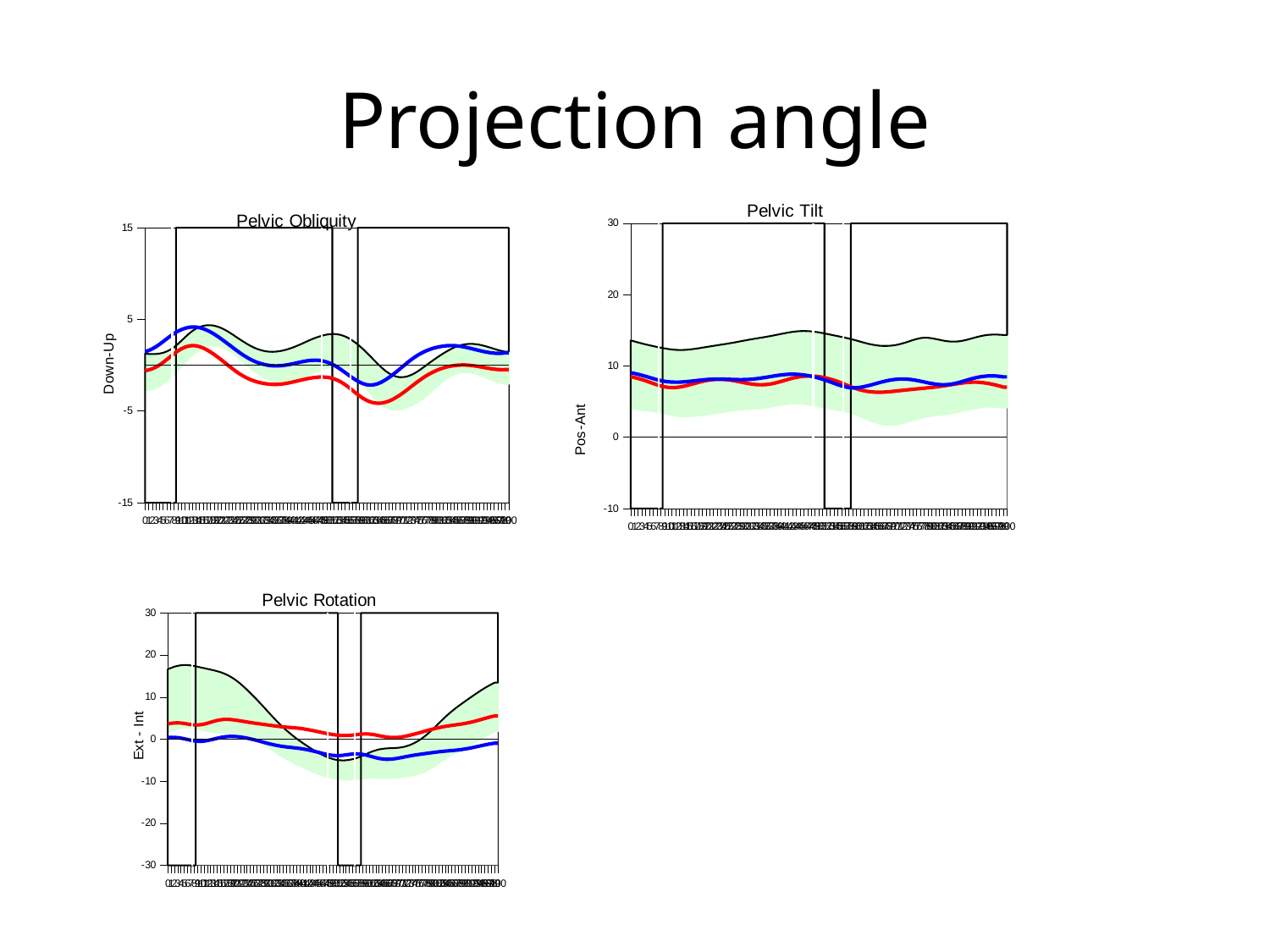
In the Pelvic Rotation chart, is the red line greater or less than 10 across the whole x axis? less What is the title of the chart in the bottom-left of the slide? Pelvic Rotation In the Pelvic Tilt chart, is the red line greater or less than 0 across the whole x axis? greater In the Pelvic Rotation chart, which line is higher at the left edge of the x axis, the red line or the blue line? red line In the Pelvic Rotation chart, is the blue line greater or less than -10 across the whole x axis? greater How many charts are shown on the slide? 3 What is the y-axis label of the Pelvic Tilt chart? Pos-Ant What kind of chart is the Pelvic Tilt chart? line chart What is the maximum value shown on the y axis of the Pelvic Obliquity chart? 15